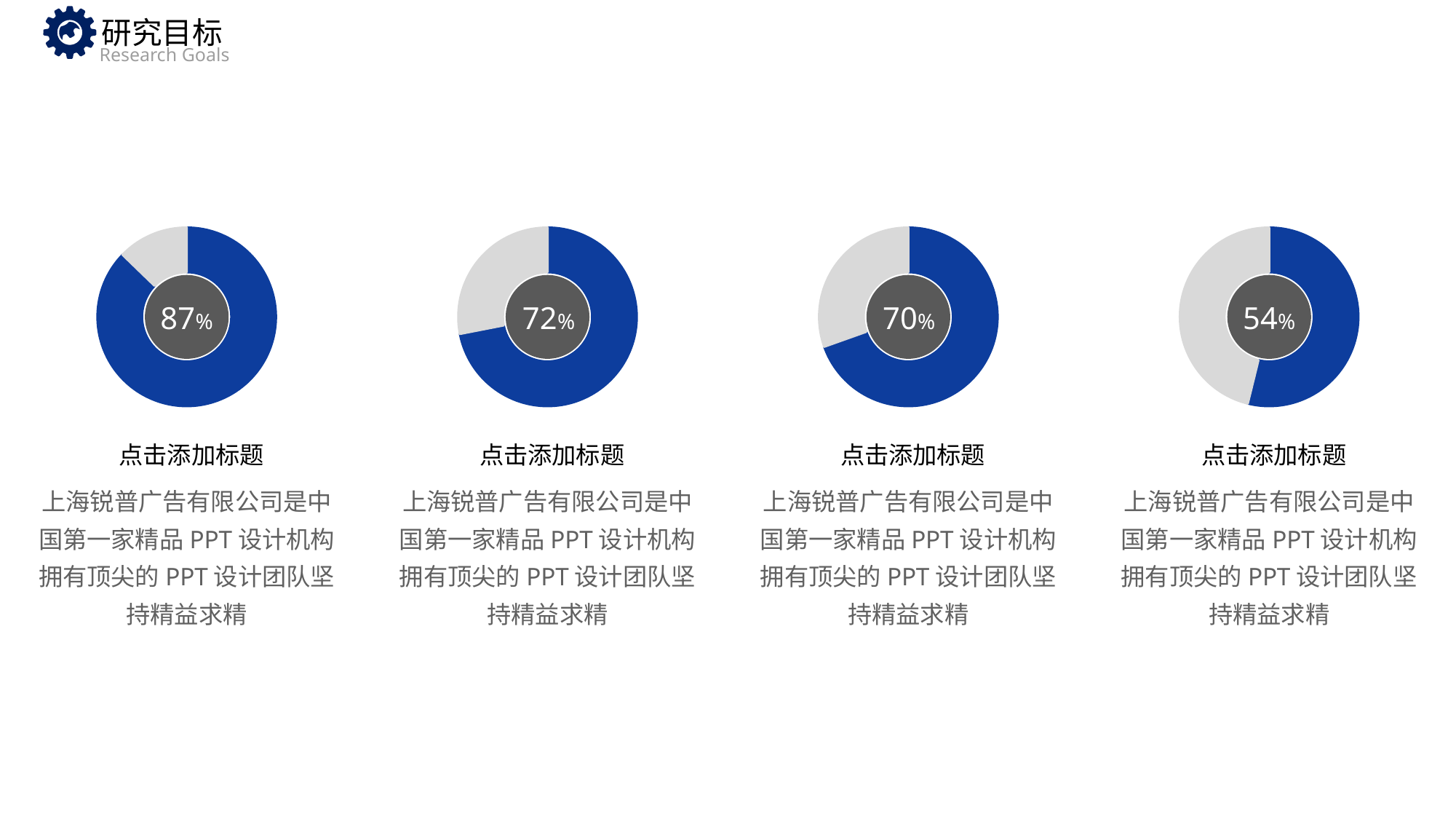
What value is shown in the centre of the leftmost chart? 87% What colour is the filled portion of the ring in each chart? Blue Which is larger, the percentage in the second chart from the left or the percentage in the third chart from the left? The second chart from the left (72%) What value is shown in the centre of the second chart from the left? 72% In the rightmost chart, what share of the ring is filled in blue? 54% How many donut charts are on the slide? 4 Which of the four charts shows the highest percentage? The leftmost chart (87%) What is the difference between the percentage in the leftmost chart and the percentage in the rightmost chart? 33% Which of the four charts shows the lowest percentage? The rightmost chart (54%) What value is shown in the centre of the rightmost chart? 54% What value is shown in the centre of the third chart from the left? 70% What kind of chart is used on this slide? Donut (pie) chart